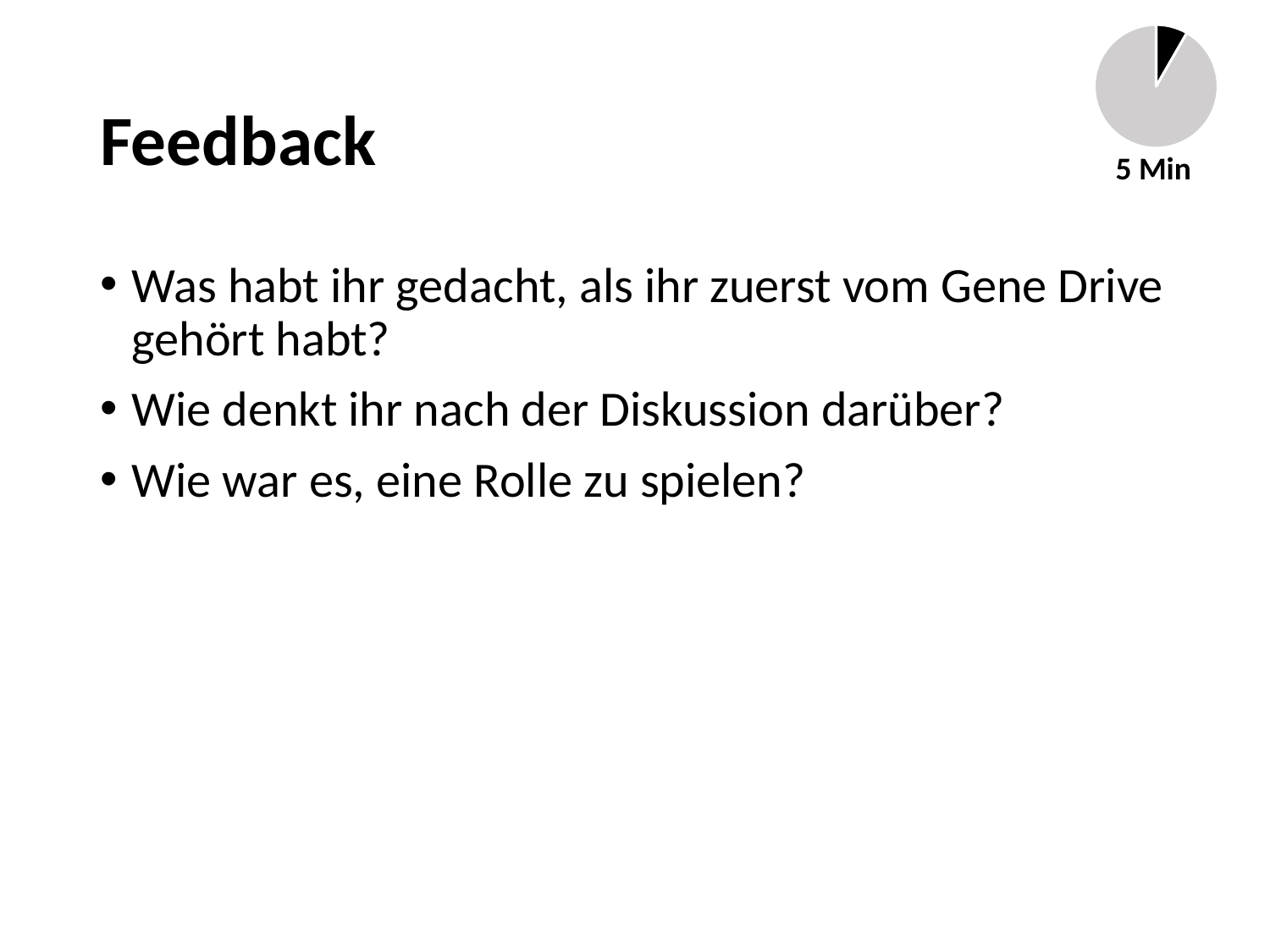
In the pie chart in the top right corner, which slice is larger, the black one or the grey one? the grey one What label is printed directly below the pie chart in the top right corner? 5 Min How many slices does the pie chart in the top right corner have? 2 Which slice takes up the largest share of the pie chart in the top right corner? the grey slice Which slice takes up the smallest share of the pie chart in the top right corner? the black slice What two colours are used for the slices of the pie chart in the top right corner? black and grey What kind of chart is shown in the top right corner of the slide? pie chart